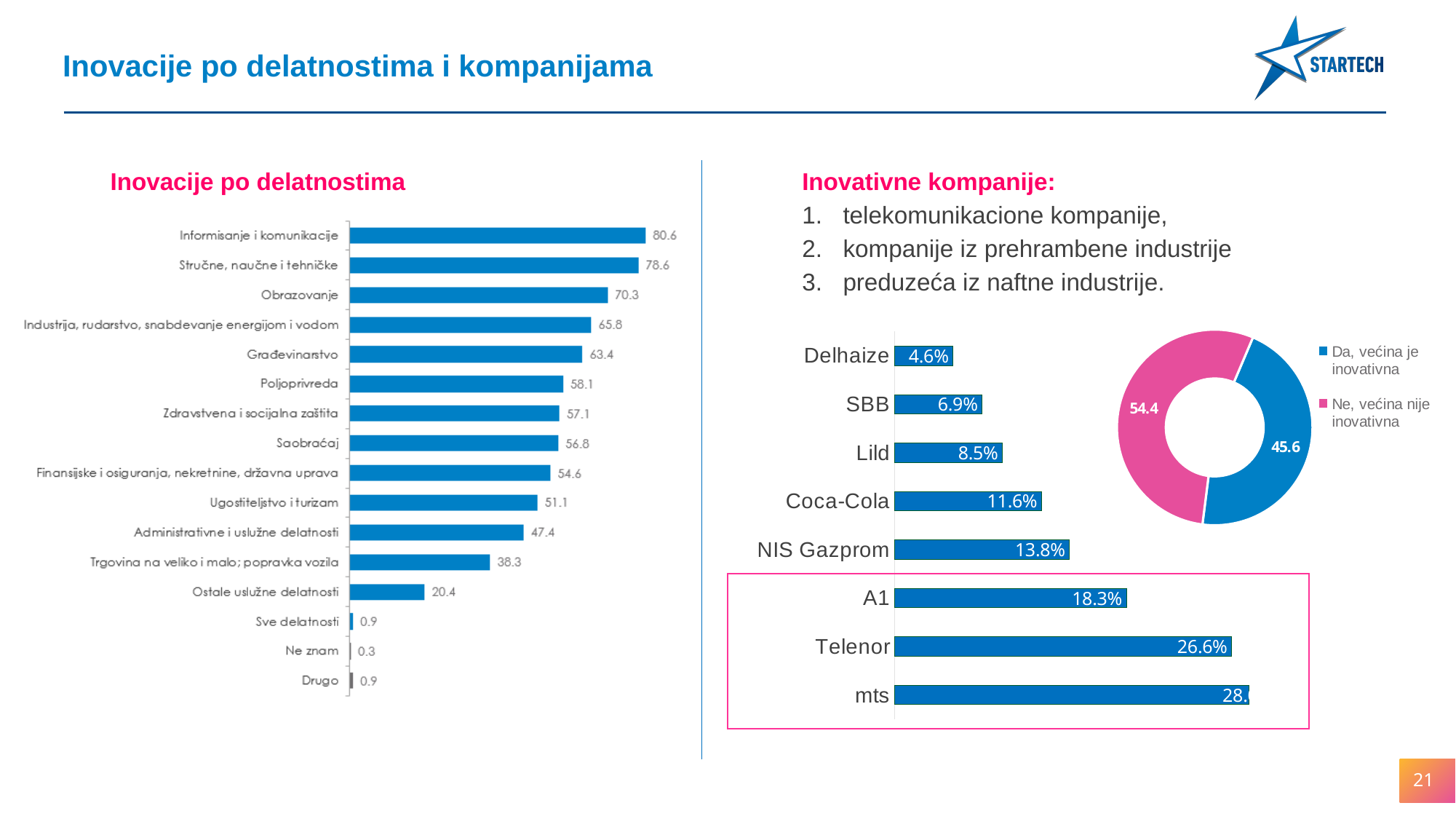
In the company bar chart on the right side of the slide, what is the difference between Telenor and A1? 8.3% In the 'Inovacije po delatnostima' bar chart, which category has the highest value? Informisanje i komunikacije In the 'Inovacije po delatnostima' bar chart, which is larger: Poljoprivreda or Saobraćaj? Poljoprivreda In the 'Inovacije po delatnostima' bar chart, what is the difference between Informisanje i komunikacije and Stručne, naučne i tehničke? 2.0 In the company bar chart on the right side of the slide, how many companies are listed? 8 In the 'Inovacije po delatnostima' bar chart, which category has the lowest value? Ne znam In the company bar chart on the right side of the slide, what is the value for Coca-Cola? 11.6% In the 'Inovacije po delatnostima' bar chart, what is the value for Obrazovanje? 70.3 In the company bar chart on the right side of the slide, which company has the highest value? mts In the donut chart on the right side of the slide, what is the value for 'Ne, većina nije inovativna'? 54.4 In the company bar chart on the right side of the slide, which company has the lowest value? Delhaize In the 'Inovacije po delatnostima' bar chart, how many categories are shown? 16